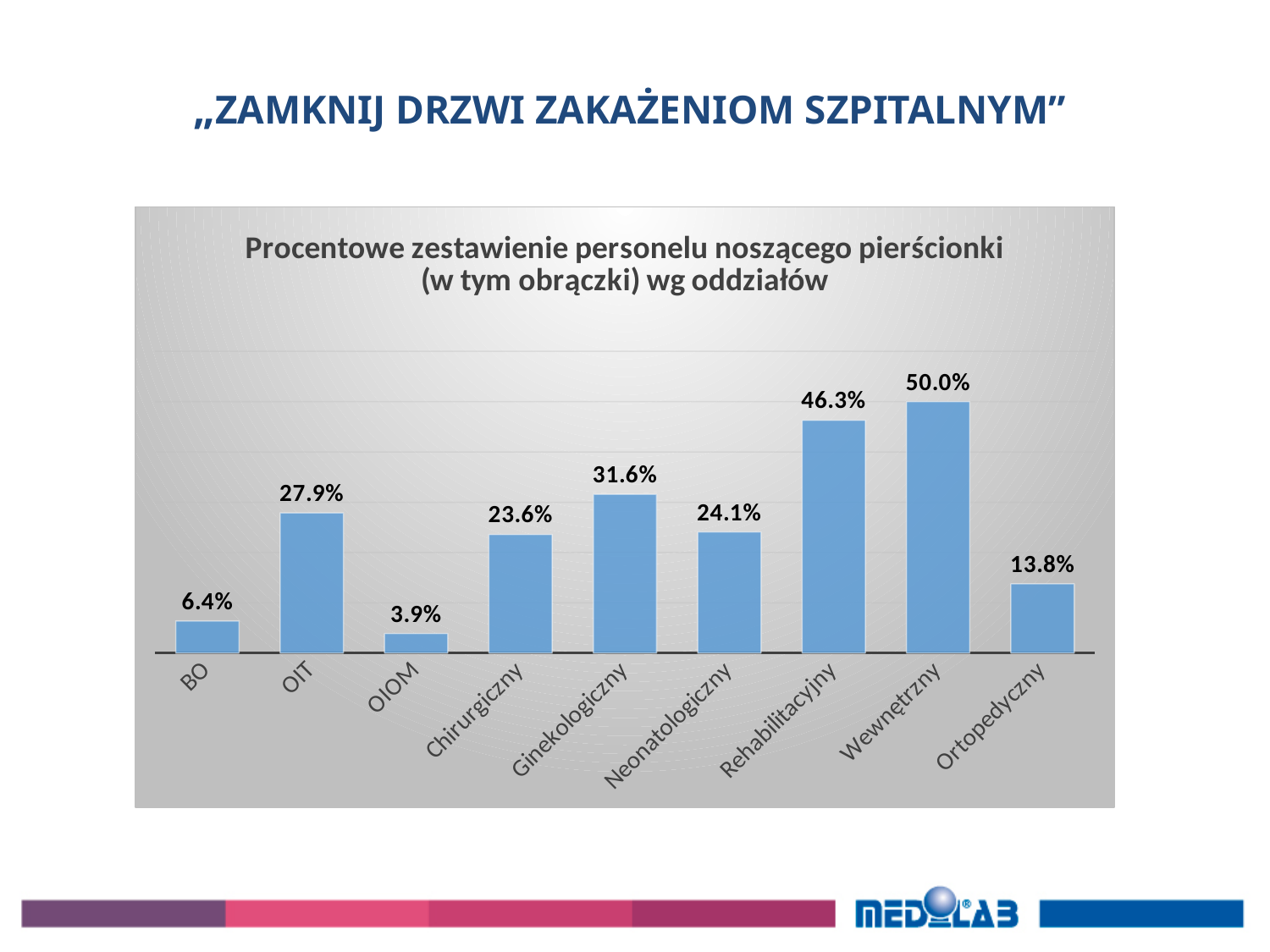
What is the value for Ortopedyczny? 13.8% What is the value for Wewnętrzny? 50.0% What is the value for Ginekologiczny? 31.6% What is the value for OIT? 27.9% What is the difference between the values for BO and OIOM? 2.5% What is the title of the chart? Procentowe zestawienie personelu noszącego pierścionki (w tym obrączki) wg oddziałów Which department has the lowest value? OIOM How many departments are shown on the chart? 9 What is the difference between the values for Wewnętrzny and Rehabilitacyjny? 3.7% What kind of chart is shown on the slide? Bar chart Which is larger, the value for Chirurgiczny or the value for Neonatologiczny? Neonatologiczny Which department has the highest value? Wewnętrzny